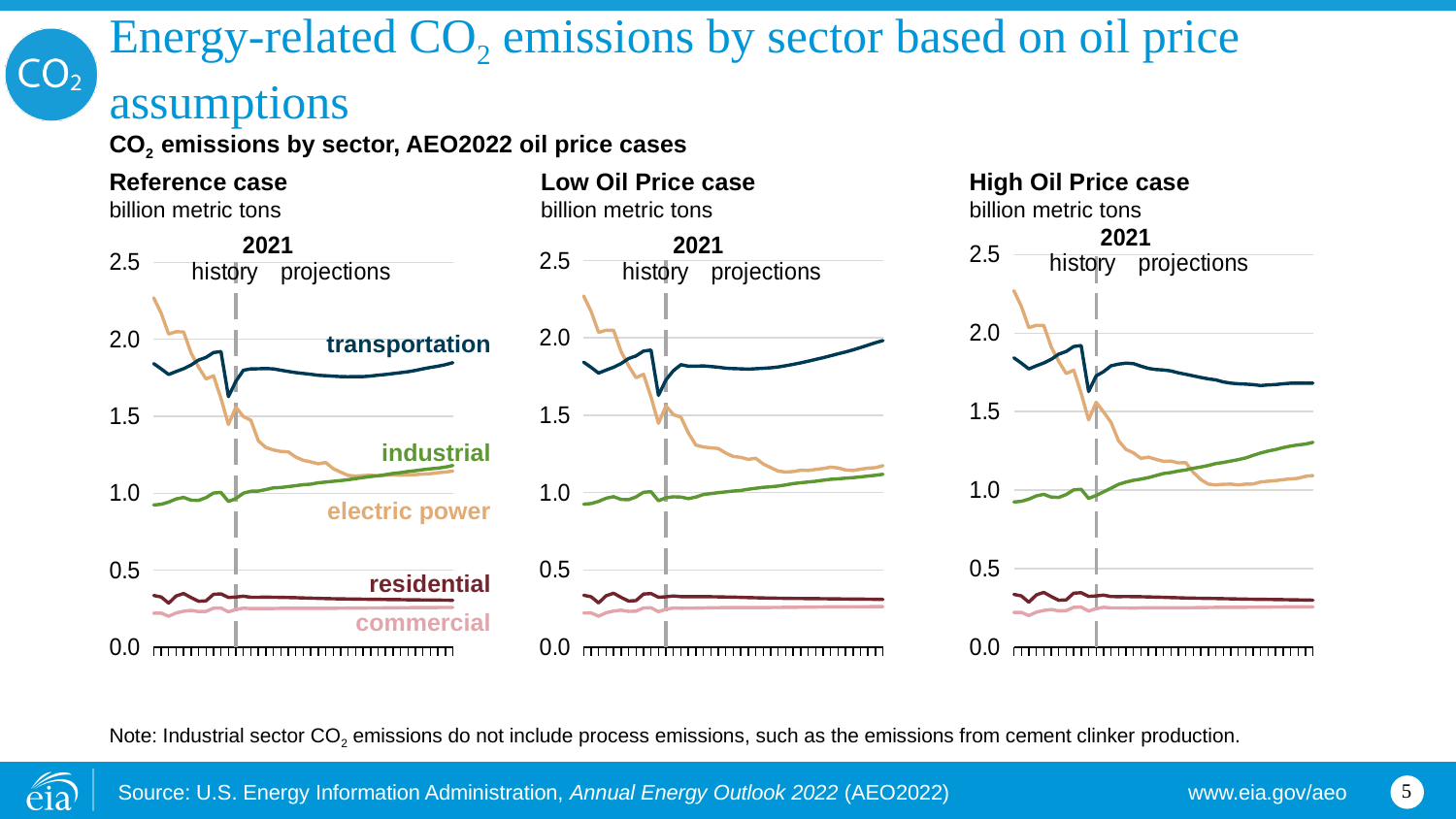
What unit is shown for the values on the three charts? billion metric tons In the Low Oil Price case chart, is the transportation value at the end of the projections greater or less than 1.5? greater In the Reference case chart, does the electric power line rise or fall over the history period? fall How many sectors are labeled on the Reference case chart? 5 In the Reference case chart, is the transportation value at the end of the projections greater or less than 1.5? greater What kind of chart is used for the Reference case? line chart In the High Oil Price case chart, is the electric power value at the end of the projections greater or less than 1.5? less In the Reference case chart, which sector has the highest emissions at the end of the projection period? transportation In the High Oil Price case chart, at the end of the projections, which is larger: industrial or electric power? industrial In the Reference case chart, which sector has the lowest emissions at the end of the projection period? commercial In the High Oil Price case chart, does the industrial line rise or fall over the projection period? rise